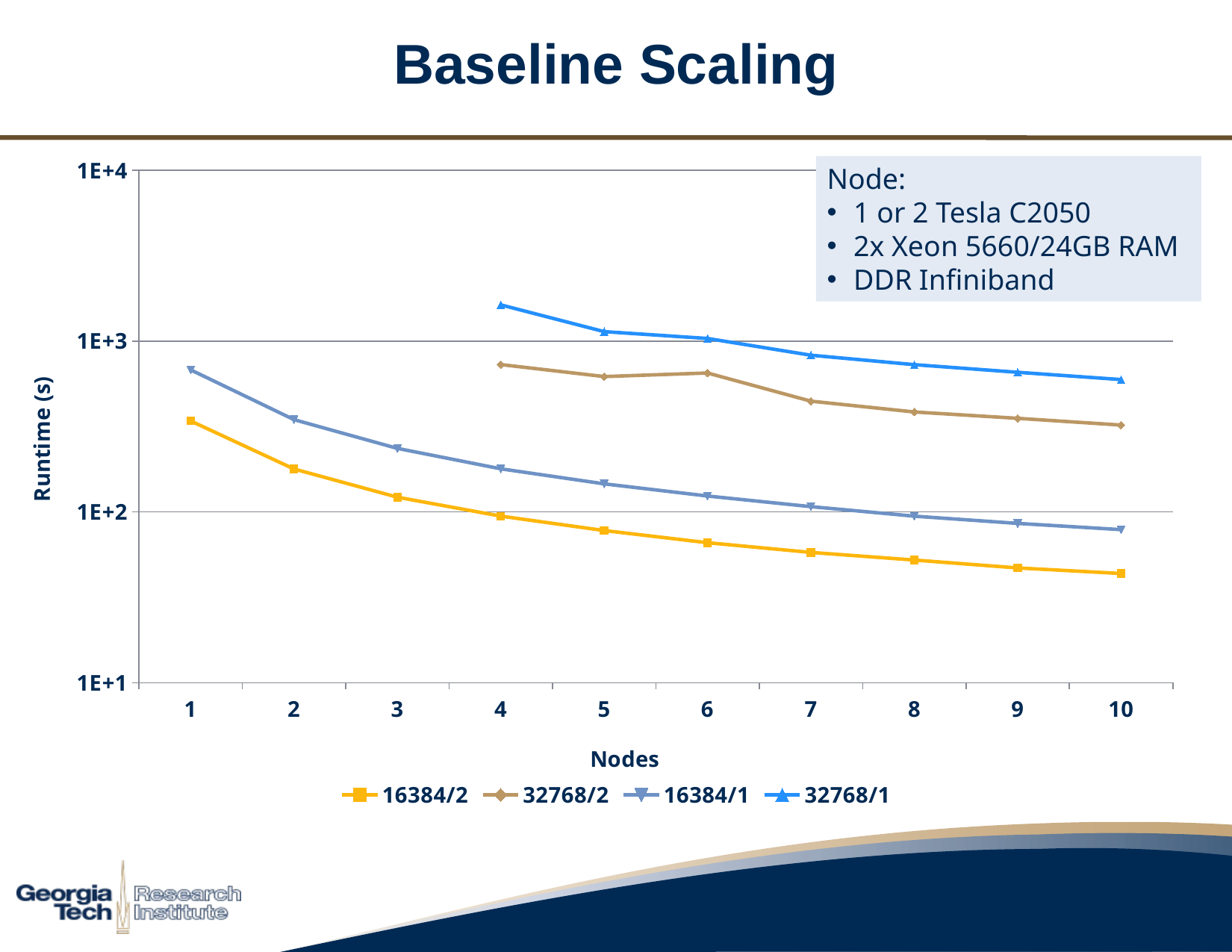
Is the runtime for the 16384/2 series at 1 node greater or less than 1E+2? greater Is the runtime for the 16384/1 series at 10 nodes greater or less than 1E+2? less Does the runtime for the 16384/2 series rise or fall as the number of nodes increases? fall What is the title of the chart's y axis? Runtime (s) Which series has the lowest runtime at 10 nodes? 16384/2 What is the title of the chart's x axis? Nodes Which series has the highest runtime at 10 nodes? 32768/1 Is the runtime for the 32768/1 series at 4 nodes greater or less than 1E+3? greater How many series does the legend list? 4 What kind of chart is shown on the slide? line chart How many node counts are shown along the x axis? 10 At 5 nodes, which series has the larger runtime, 32768/1 or 32768/2? 32768/1